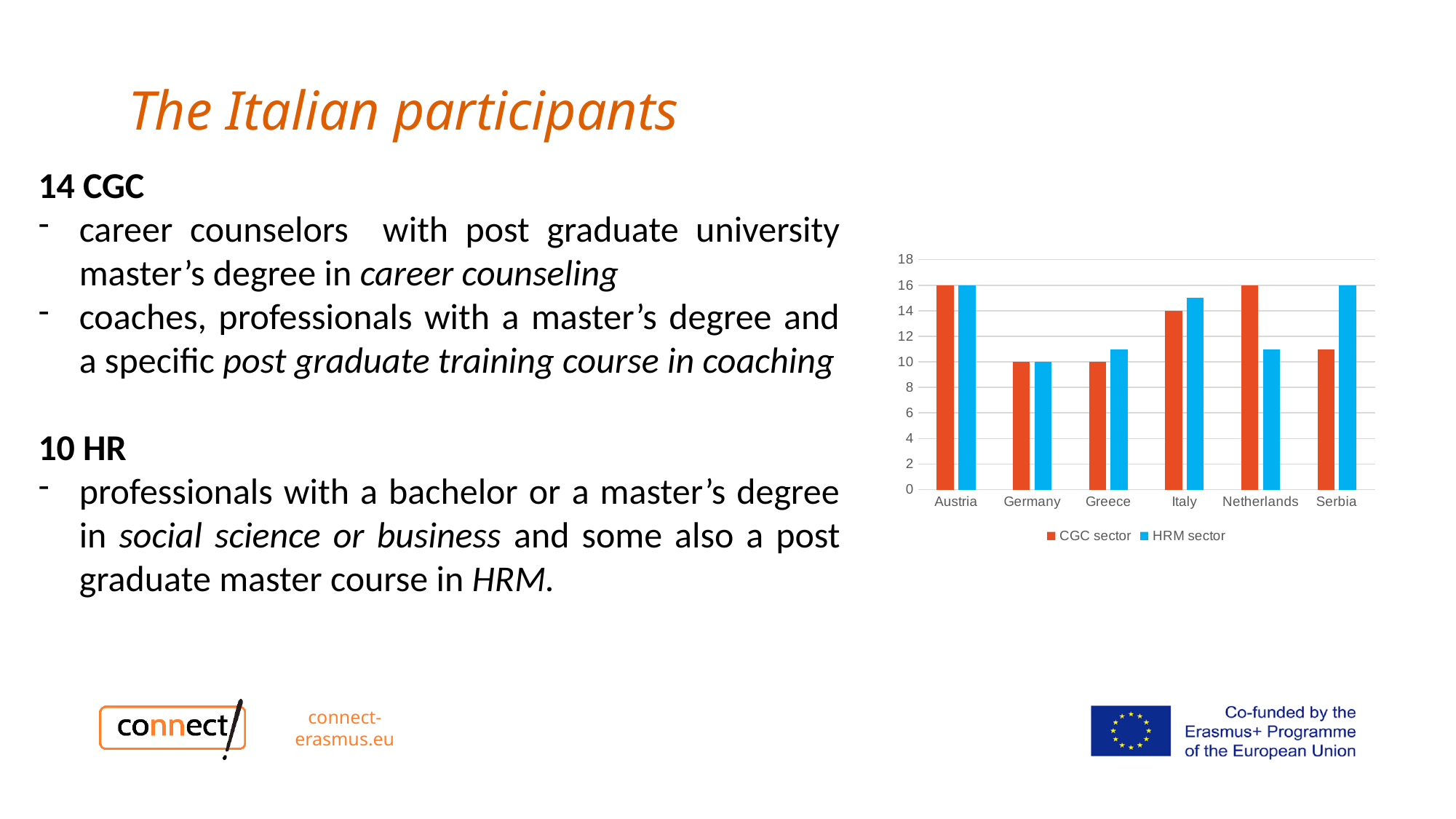
What is the value for the CGC sector in the Netherlands? 16 Which colour represents the CGC sector in the chart? orange What is the value for the CGC sector in Austria? 16 In the Netherlands, which series has the larger value, CGC sector or HRM sector? CGC sector What is the difference between the CGC sector values for the Netherlands and Germany? 6 Is the value for the HRM sector in the Netherlands greater or less than 12? less Is the value for the HRM sector in Serbia greater or less than 14? greater How many countries are shown on the x axis of the chart? 6 What is the value for the HRM sector in Germany? 10 What kind of chart is shown on the slide? bar chart What is the value for the CGC sector in Italy? 14 How many series does the chart legend list? 2